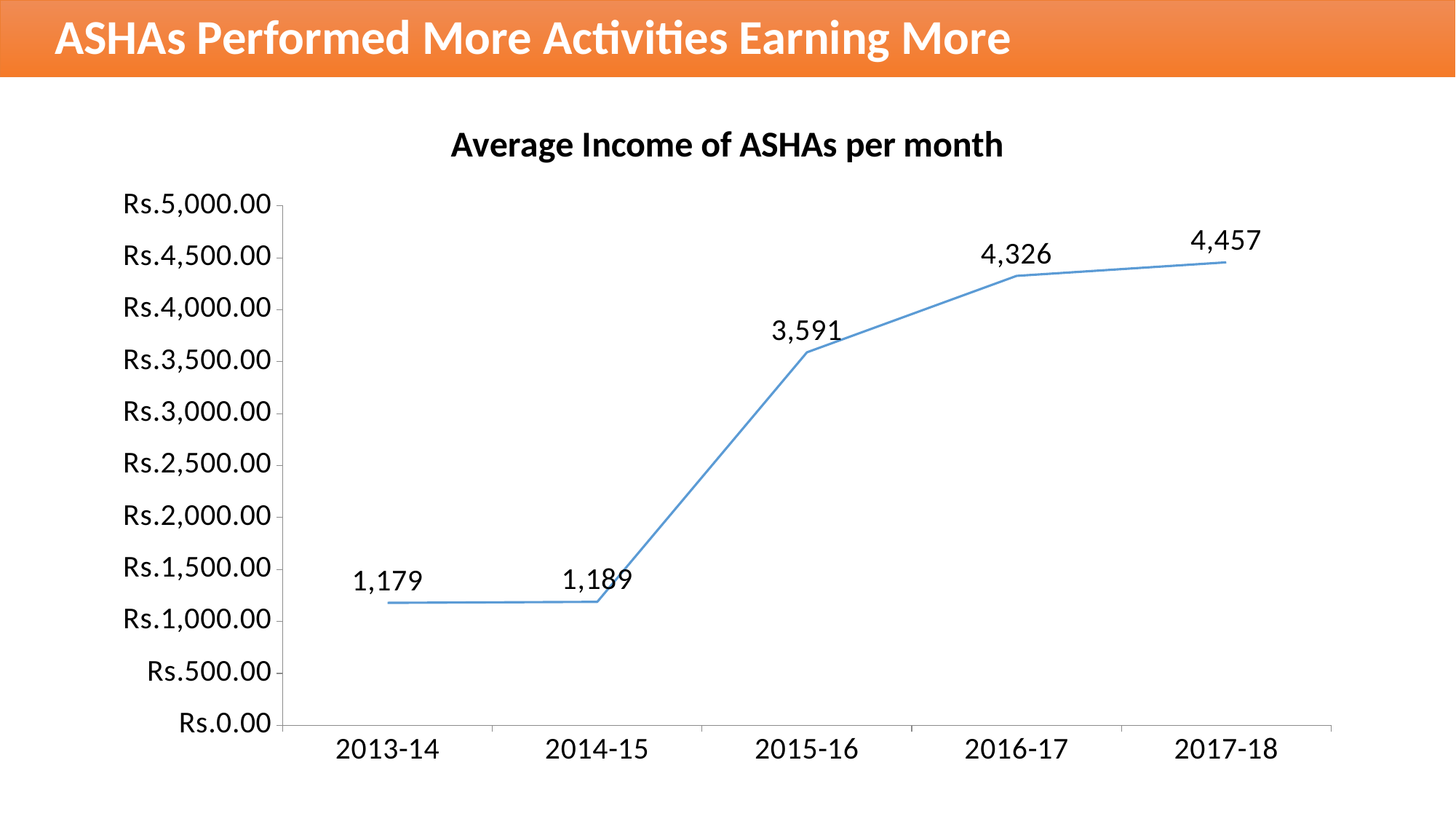
What is the difference between the average income in 2014-15 and 2013-14? 10 Which year has the highest average income of ASHAs per month? 2017-18 What is the difference between the average income in 2016-17 and 2015-16? 735 Is the average income for 2016-17 greater or less than Rs.4,000.00? greater What is the average income of ASHAs per month in 2013-14? 1,179 What kind of chart is shown on the slide? line chart Does the average income of ASHAs per month rise or fall from 2013-14 to 2017-18? rise Which year has the lowest average income of ASHAs per month? 2013-14 How many years are plotted on the chart? 5 What is the average income of ASHAs per month in 2017-18? 4,457 Which is larger, the average income in 2015-16 or in 2016-17? 2016-17 What is the average income of ASHAs per month in 2015-16? 3,591